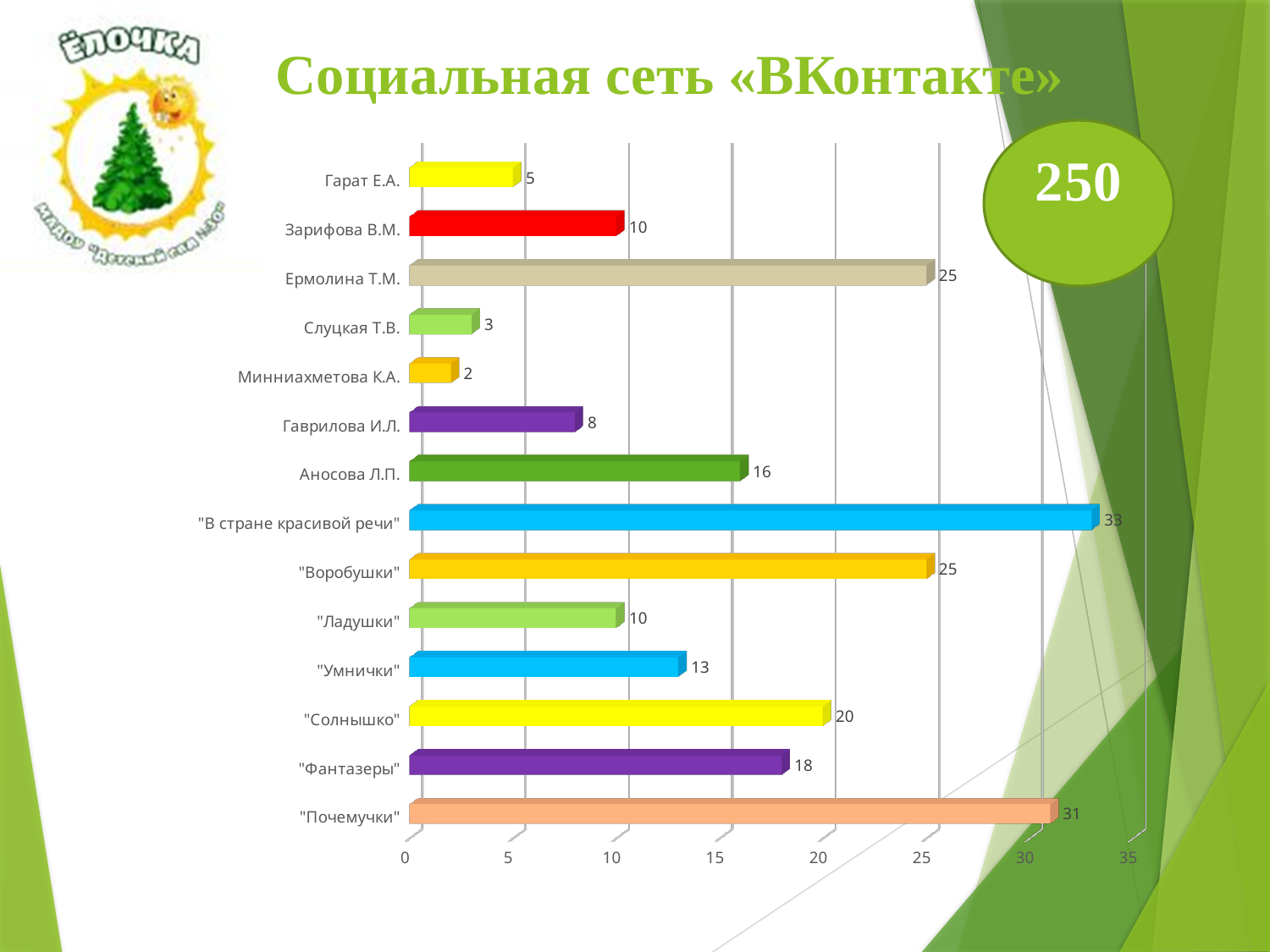
What kind of chart is shown on the slide? Bar chart What is the value for "Почемучки"? 31 What is the difference between the values for "В стране красивой речи" and "Почемучки"? 2 Which category has the lowest value? Минниахметова К.А. What is the value for Ермолина Т.М.? 25 What is the title of the slide? Социальная сеть «ВКонтакте» What is the difference between the values for "Фантазеры" and "Умнички"? 5 What is the value for "Солнышко"? 20 Which is larger, the value for Аносова Л.П. or the value for "Ладушки"? Аносова Л.П. How many categories are shown in the chart? 14 What is the value for Гаврилова И.Л.? 8 Which category has the highest value? "В стране красивой речи"